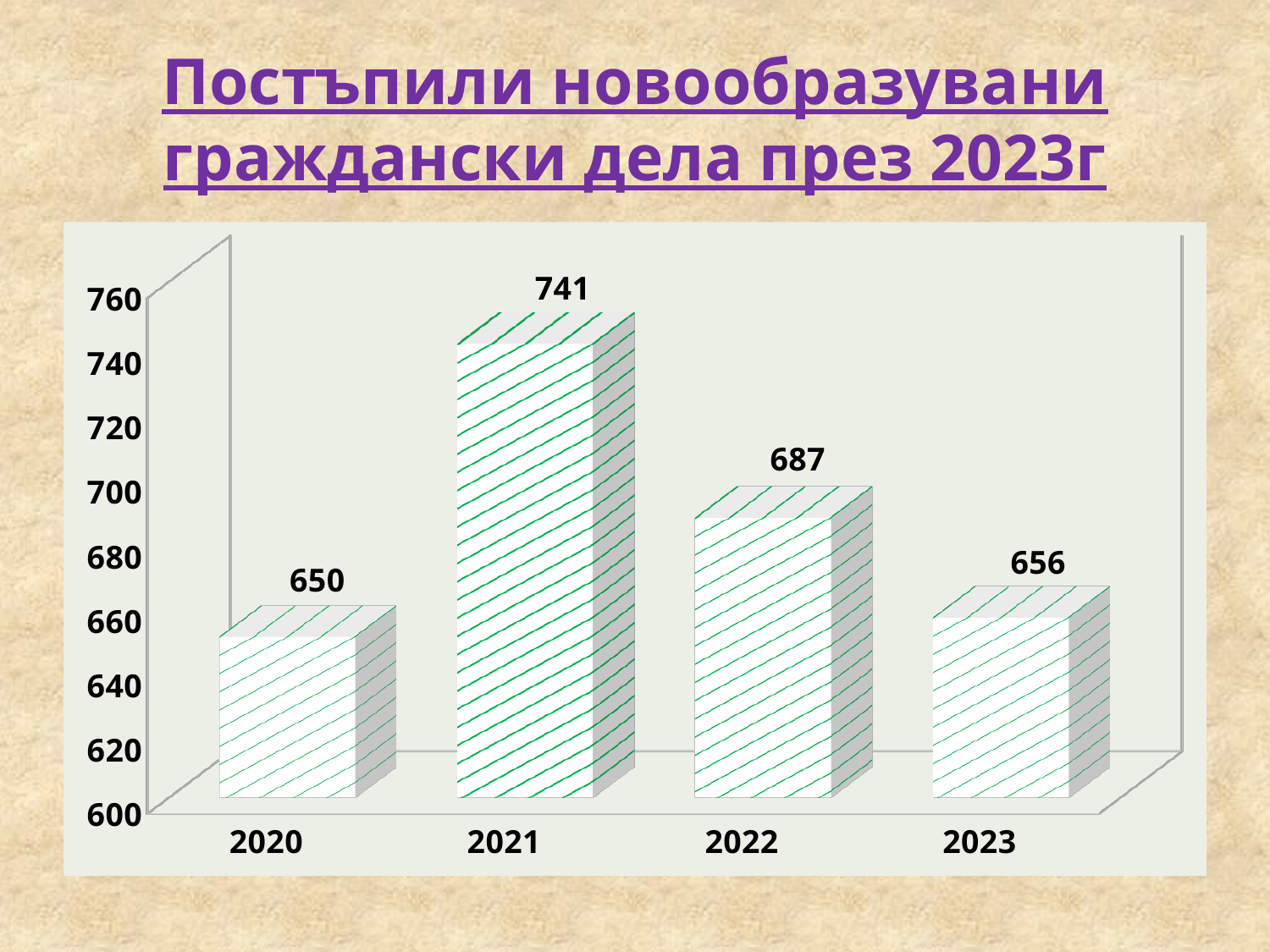
How many years are shown on the x axis? 4 Which year has the lowest value? 2020 What is the difference between the values for 2021 and 2022? 54 What is the value for 2020? 650 What is the value for 2021? 741 Does the value rise or fall from 2021 to 2023? fall Is the value for 2022 greater or less than 700? less Which year has the highest value? 2021 What is the value for 2023? 656 What kind of chart is shown on the slide? bar chart Which is larger, the value for 2022 or the value for 2023? 2022 What is the difference between the values for 2023 and 2020? 6